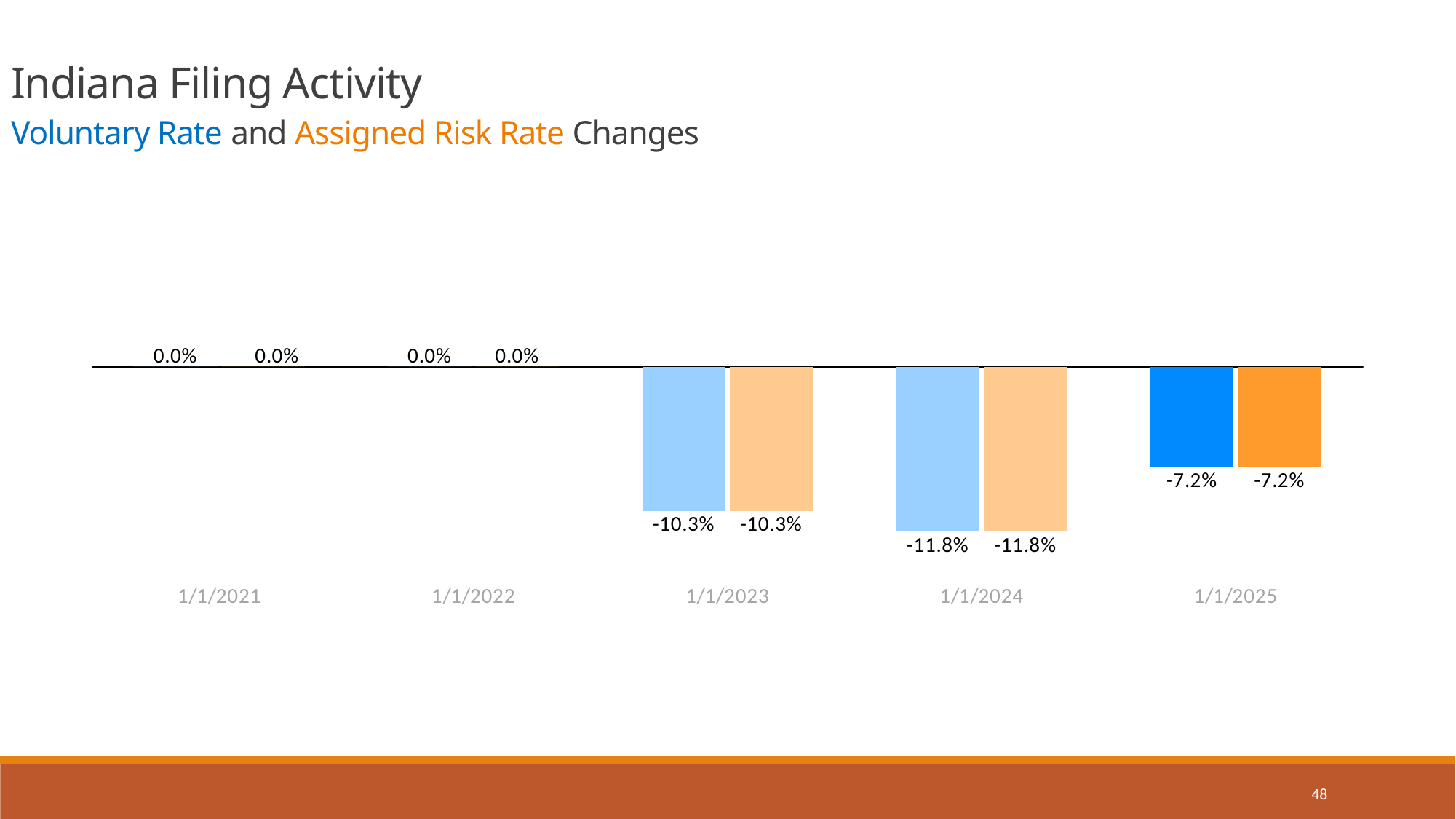
Which is larger, the Voluntary Rate change on 1/1/2025 or on 1/1/2023? 1/1/2025 What is the difference between the Assigned Risk Rate change on 1/1/2023 and on 1/1/2024? 1.5 percentage points What is the Voluntary Rate change for 1/1/2023? -10.3% Which date shows the largest rate decrease for the Voluntary Rate? 1/1/2024 How many dates are shown on the x axis of the chart? 5 What is the difference between the Voluntary Rate change on 1/1/2024 and on 1/1/2025? 4.6 percentage points What is the Assigned Risk Rate change for 1/1/2021? 0.0% Which colour represents the Assigned Risk Rate series? Orange What is the Voluntary Rate change for 1/1/2025? -7.2% What kind of chart is shown on the slide? Bar chart What is the Assigned Risk Rate change for 1/1/2024? -11.8% How many series does the chart plot? 2